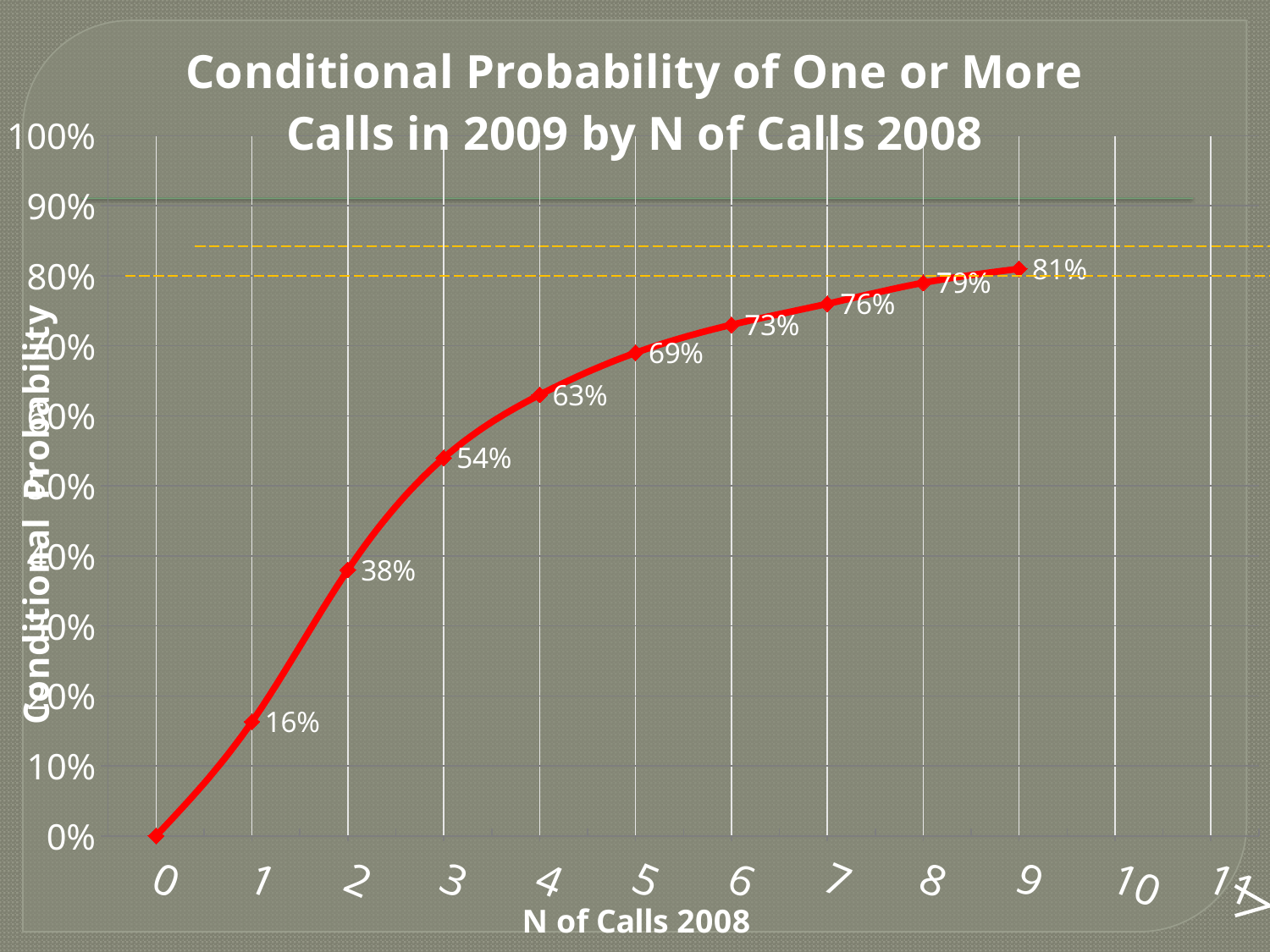
What is the conditional probability for N of Calls 2008 = 2? 38% What is the conditional probability for N of Calls 2008 = 9? 81% What kind of chart is shown on the slide? line chart How many data points are plotted on the line? 10 What is the conditional probability for N of Calls 2008 = 1? 16% Is the conditional probability at N = 7 greater or less than 70%? greater Which N of Calls 2008 value has the lowest conditional probability? 0 What is the difference between the conditional probability at N = 3 and at N = 2? 16% What is the conditional probability for N of Calls 2008 = 5? 69% Which N of Calls 2008 value has the highest conditional probability? 9 Do the values rise or fall as N of Calls 2008 increases? rise Which is larger, the conditional probability at N = 4 or at N = 6? N = 6